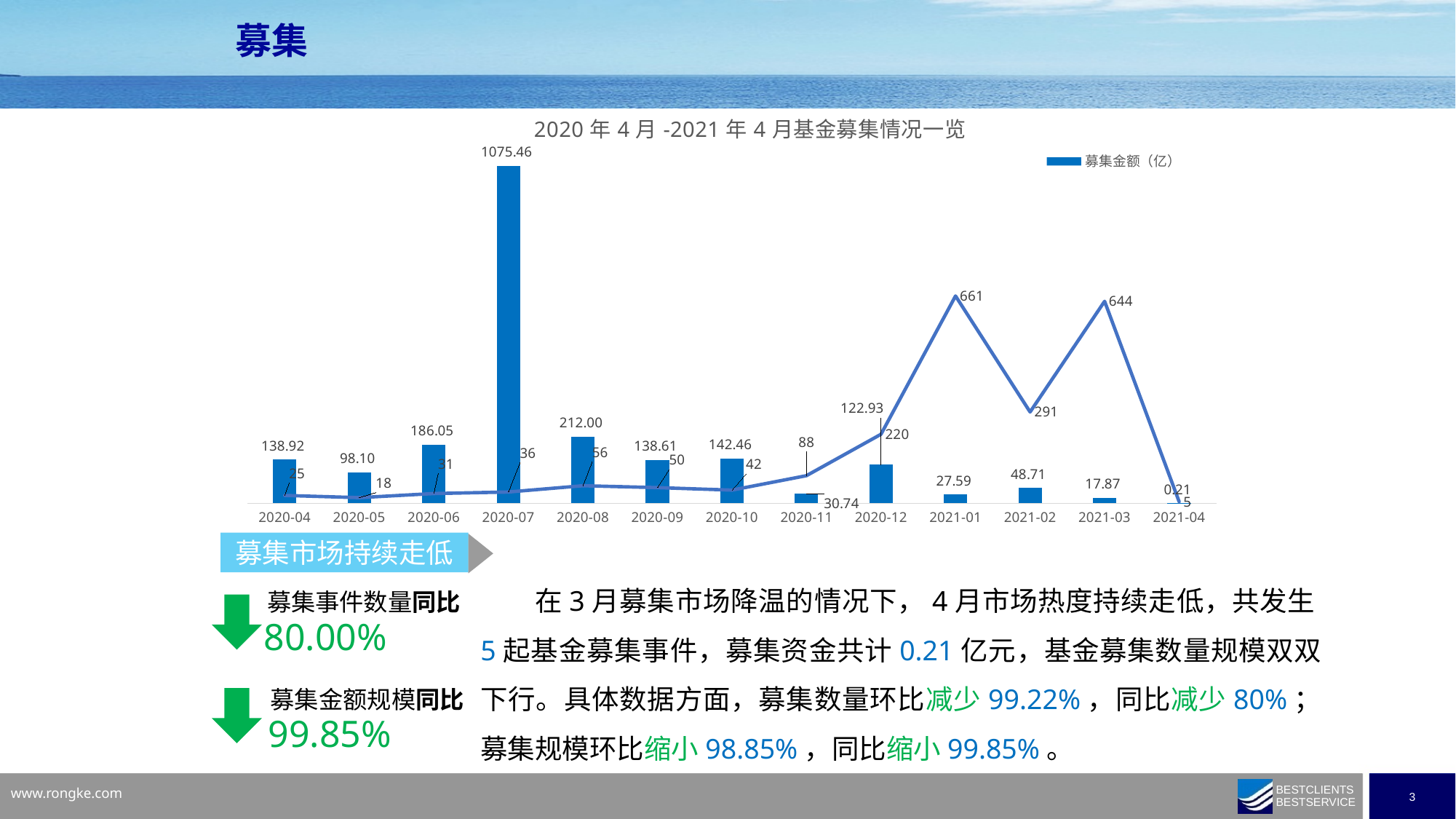
What kind of chart is shown on the slide? Combined bar and line chart What is the 募集金额（亿） value for 2020-07? 1075.46 Which is larger, the 募集金额（亿） value for 2020-06 or for 2020-10? 2020-06 How many series does the legend list? 1 How many months are shown on the x axis of the chart? 13 What is the difference between the 募集金额（亿） values for 2020-08 and 2020-09? 73.39 Does the line rise or fall from 2020-10 to 2021-01? Rise What is the 募集金额（亿） value for 2020-12? 122.93 Which month has the lowest 募集金额（亿） bar? 2021-04 Which month has the highest 募集金额（亿） bar? 2020-07 What is the 募集金额（亿） value for 2021-04? 0.21 What value does the line show for 2021-01? 661